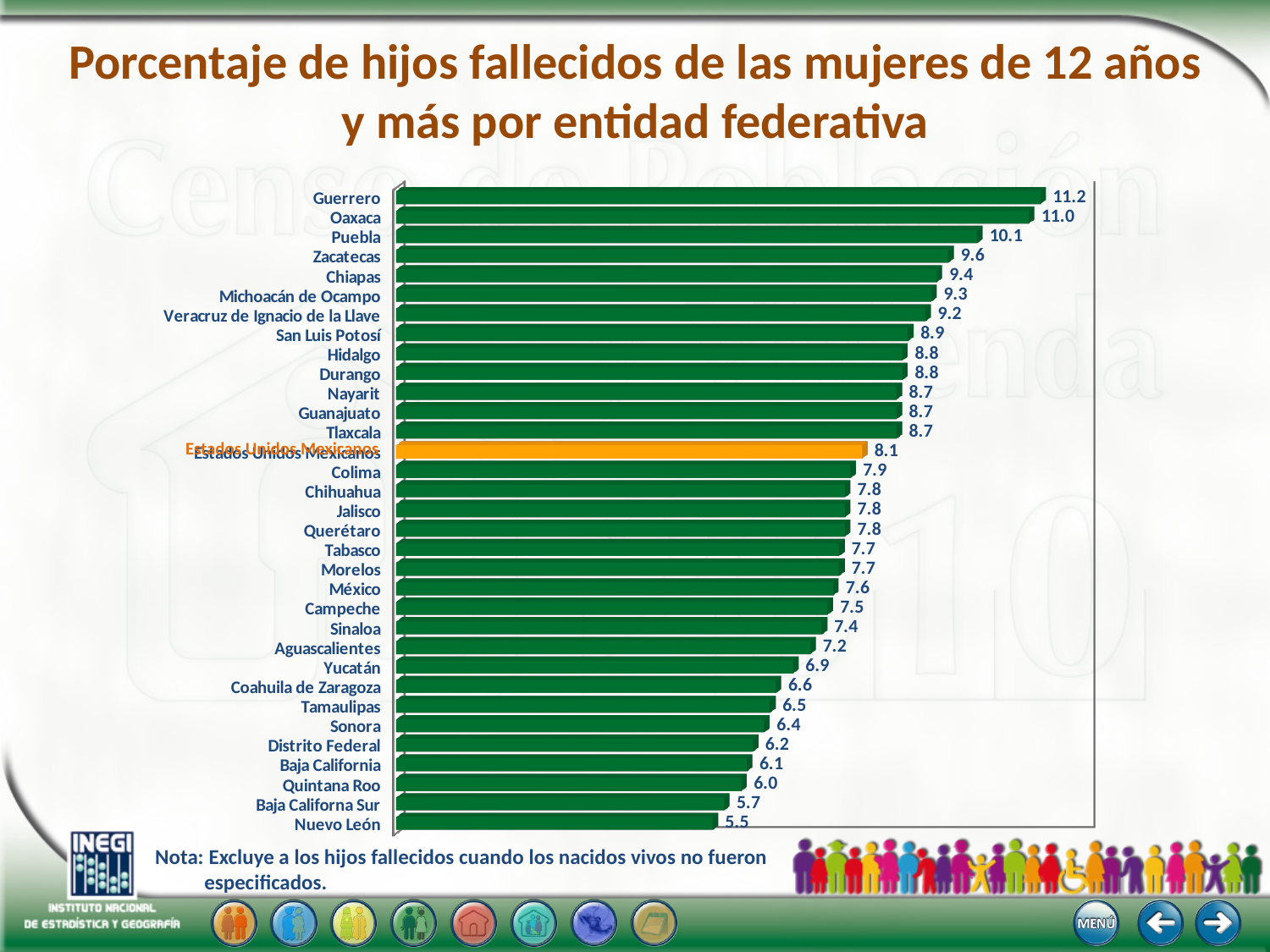
Which entity has the lowest value? Nuevo León Which entity has the highest value? Guerrero How many entities are shown in the chart? 33 Which has a larger value, Yucatán or Colima? Colima What kind of chart is shown on the slide? Bar chart What is the difference between the values for Guerrero and Nuevo León? 5.7 What is the value for Estados Unidos Mexicanos? 8.1 What is the difference between the values for Puebla and Estados Unidos Mexicanos? 2.0 Which has a larger value, Chiapas or Sonora? Chiapas Which bar is highlighted in a different colour (orange) from the rest? Estados Unidos Mexicanos What is the value for Distrito Federal? 6.2 What is the value for Guerrero? 11.2